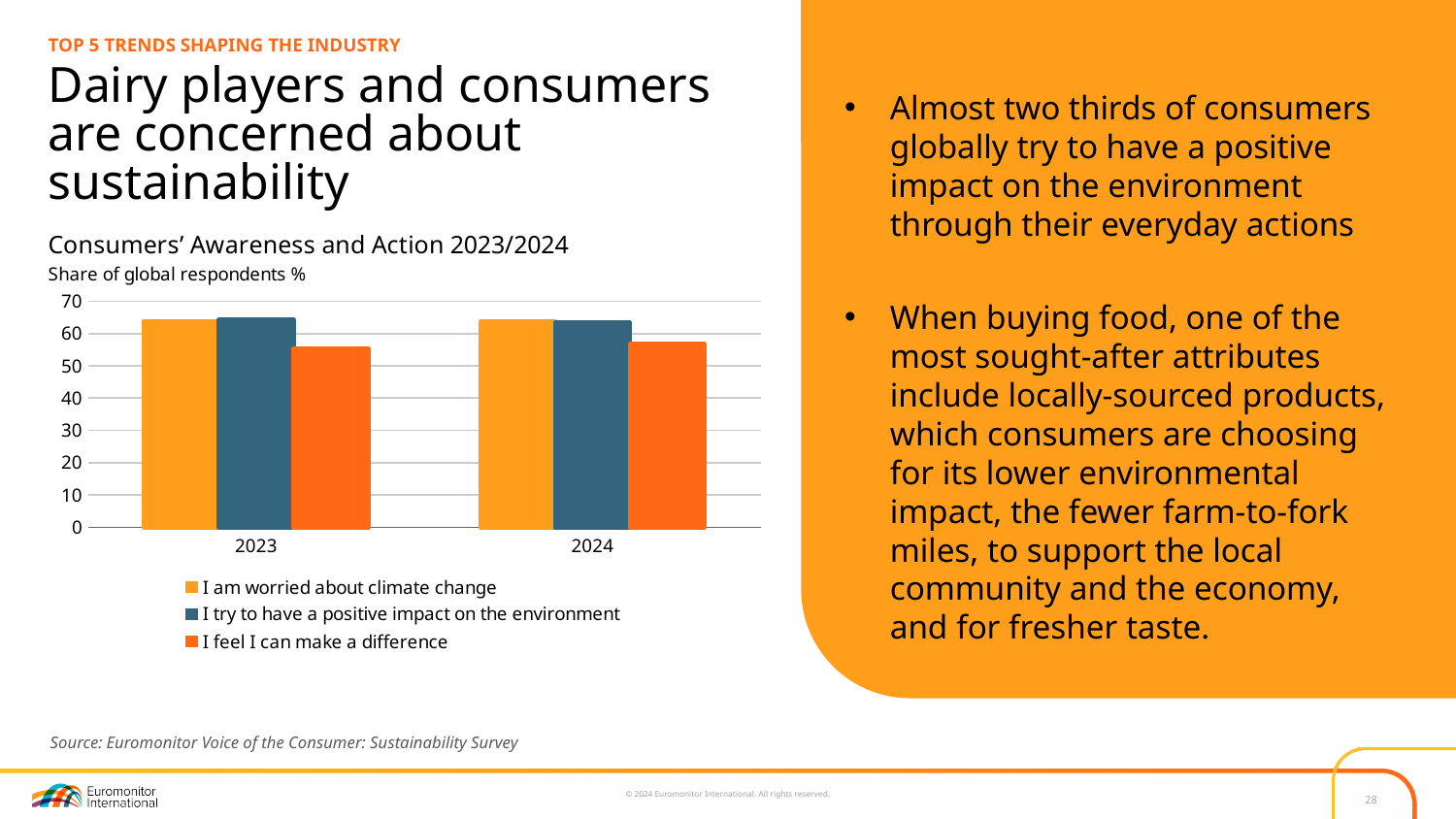
Which series has the lowest value in 2024? I feel I can make a difference In 2024, which is larger: 'I am worried about climate change' or 'I feel I can make a difference'? I am worried about climate change What kind of chart is shown on the slide? bar chart Is the value for 'I try to have a positive impact on the environment' in 2024 greater or less than 60? greater Is the value for 'I am worried about climate change' in 2023 greater or less than 60? greater What is the title of the chart? Consumers' Awareness and Action 2023/2024 Which series has the lowest value in 2023? I feel I can make a difference How many series does the chart legend list? 3 How many year categories are shown on the x axis of the chart? 2 What unit is the chart's y axis measured in, according to the subtitle? Share of global respondents % Is the value for 'I feel I can make a difference' in 2023 greater or less than 60? less